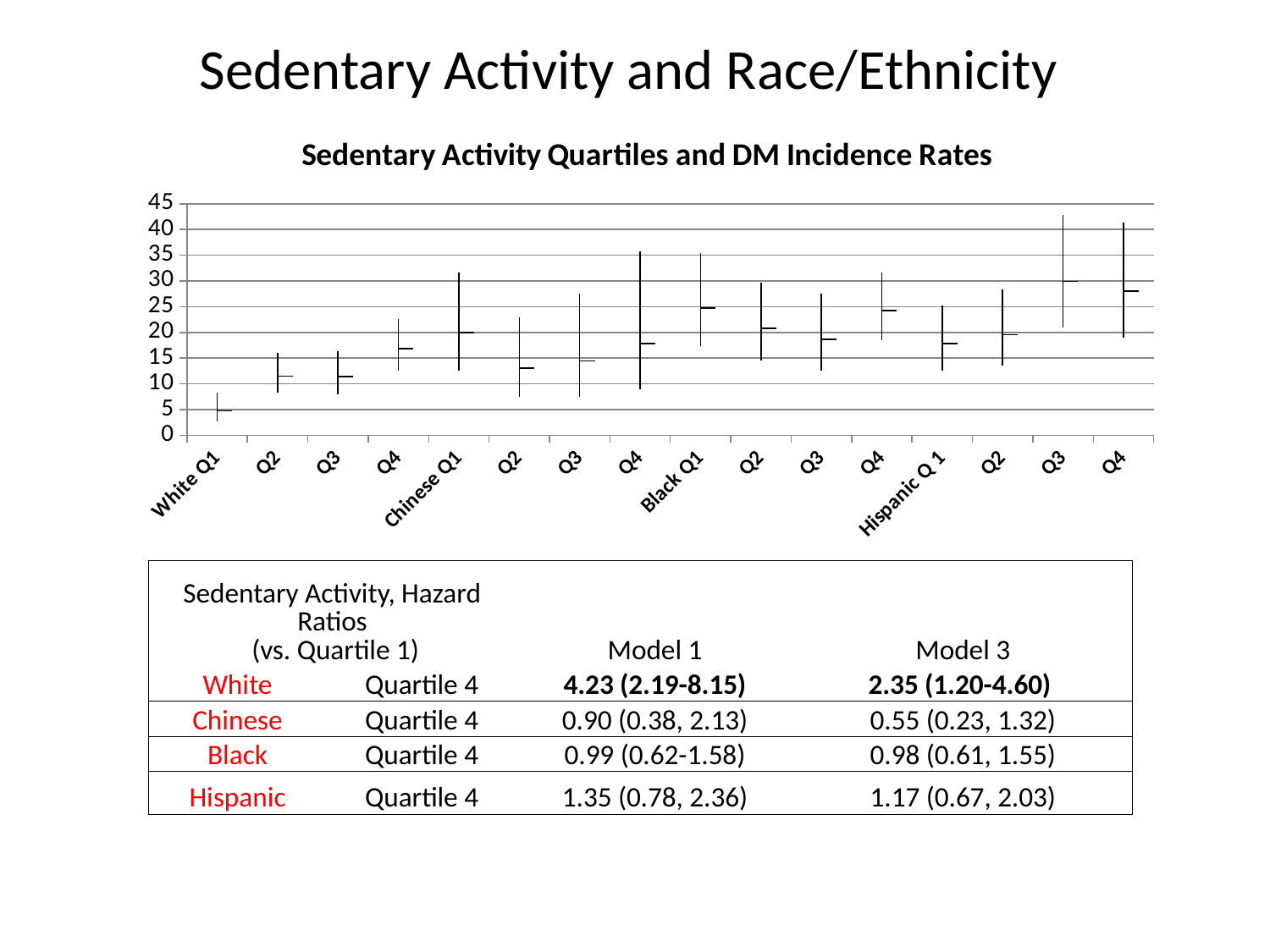
Which category has the lowest plotted value in the chart? White Q1 Is the plotted value for Chinese Q2 greater or less than 15? less Which has the larger plotted value, White Q1 or Hispanic Q3? Hispanic Q3 What is the title of the chart? Sedentary Activity Quartiles and DM Incidence Rates Is the plotted value for Hispanic Q4 greater or less than 25? greater Which has the larger plotted value, White Q2 or Black Q1? Black Q1 Is the plotted value for Hispanic Q3 greater or less than 25? greater How many categories are shown on the x axis of the chart? 16 What is the highest value shown on the y axis of the chart? 45 Do the plotted values for the White group rise or fall from Q1 to Q4? rise